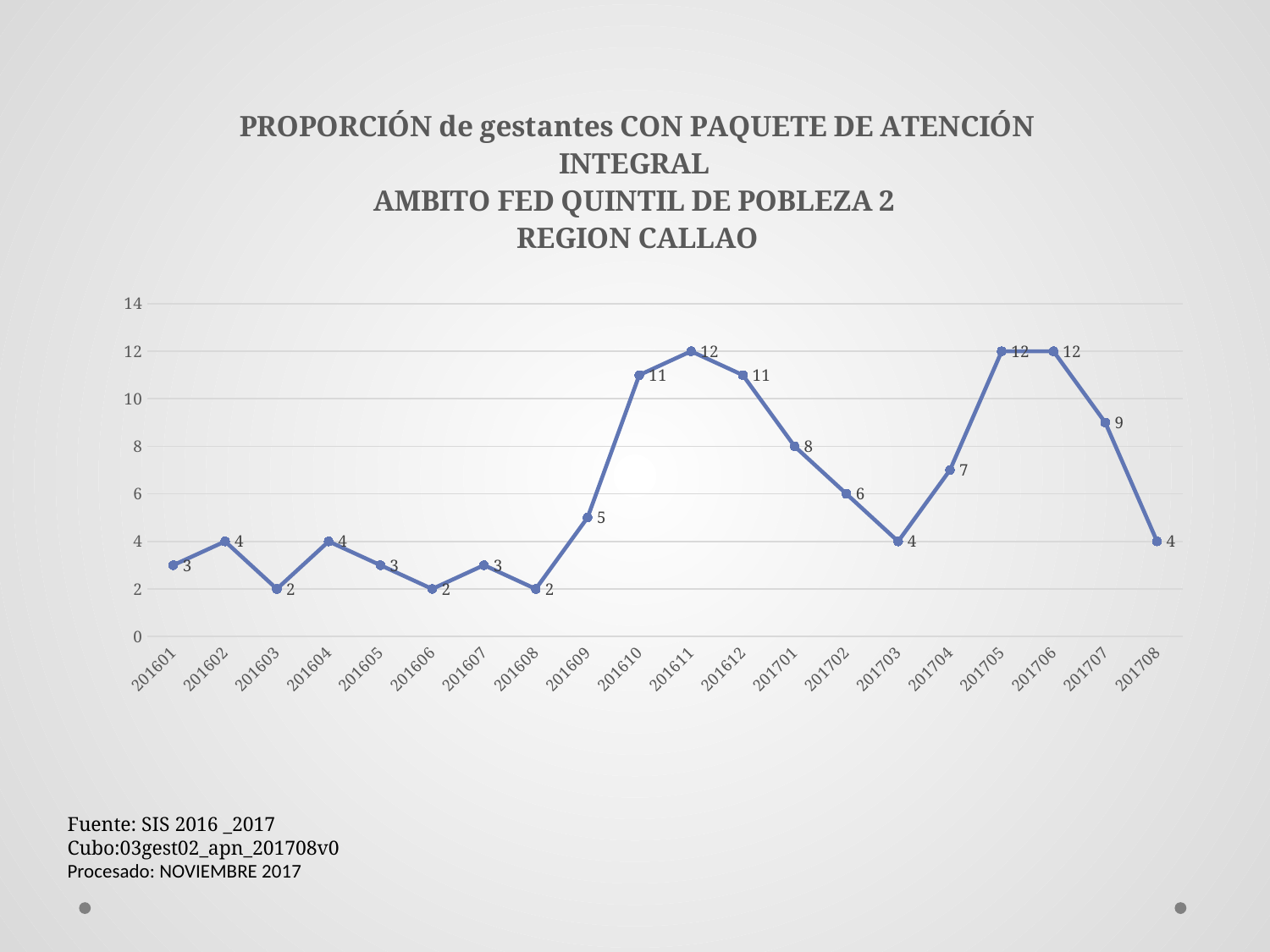
What is the value for 201609? 5 How many data points are plotted on the chart? 20 What is the highest value plotted on the chart? 12 Do the values rise or fall from 201705 to 201708? fall Which has a larger value, 201704 or 201702? 201704 What is the value for 201701? 8 What is the difference between the values for 201611 and 201612? 1 What is the difference between the values for 201707 and 201708? 5 What is the lowest value plotted on the chart? 2 What is the value for 201610? 11 What is the value for 201708? 4 What type of chart is shown on the slide? line chart